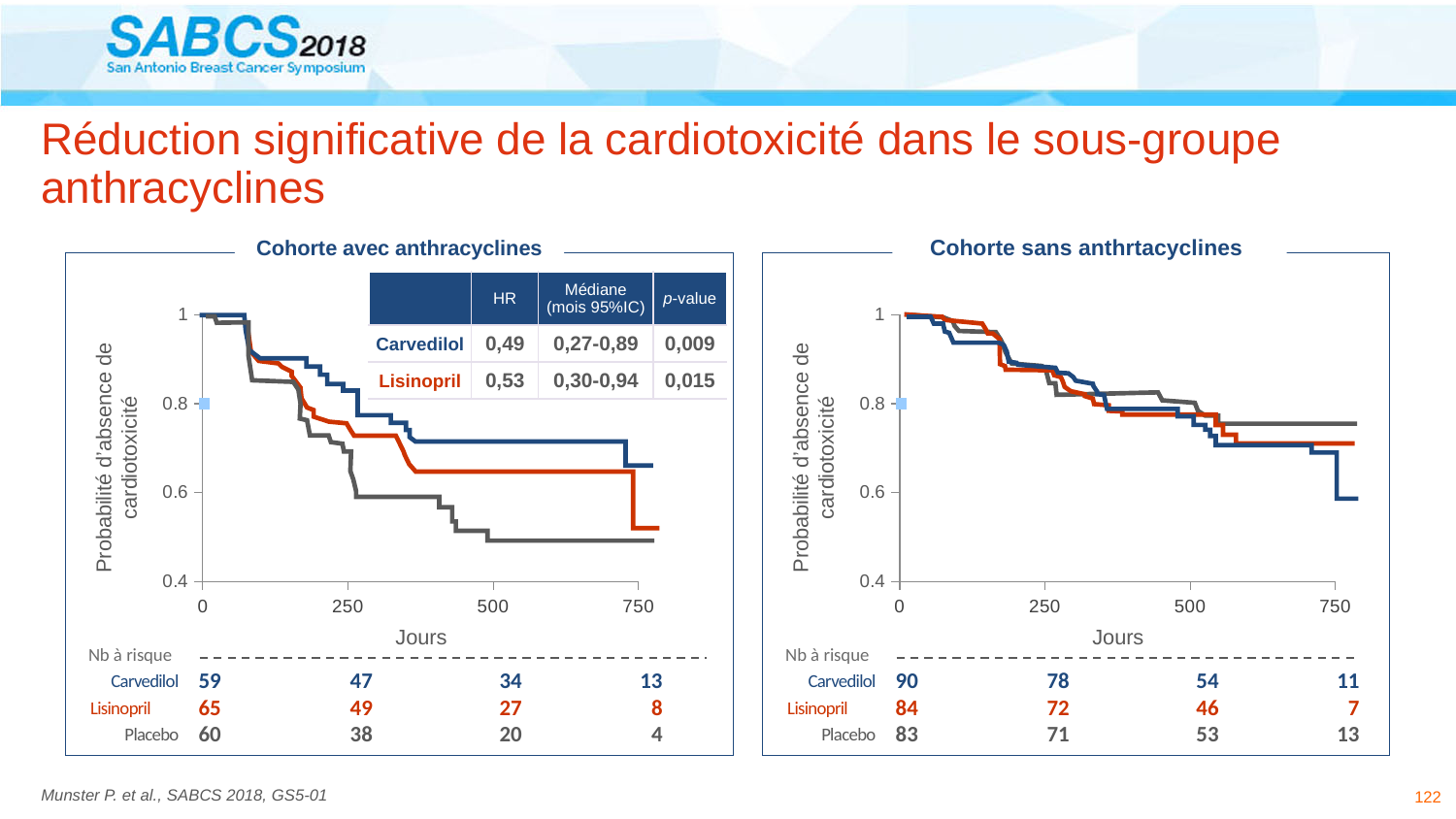
In the 'Cohorte avec anthracyclines' chart, what is the HR for Carvedilol in the inset table? 0,49 In the 'Cohorte sans anthrtacyclines' chart, which is larger at 750 days: the number at risk for Placebo or for Carvedilol? Placebo How many treatment groups are listed in the 'Nb à risque' table of the 'Cohorte sans anthrtacyclines' chart? 3 What kind of chart is shown under the title 'Cohorte avec anthracyclines'? Line chart In the 'Cohorte sans anthrtacyclines' chart, do the curves rise or fall as days increase? Fall In the 'Cohorte sans anthrtacyclines' chart, how many Lisinopril patients are at risk at 250 days? 72 In the 'Cohorte avec anthracyclines' chart, what is the p-value for Lisinopril in the inset table? 0,015 In the 'Cohorte avec anthracyclines' chart, is the Placebo curve at 500 days greater or less than 0.6? less In the 'Cohorte avec anthracyclines' chart, which group has the largest number at risk at day 0? Lisinopril In the 'Cohorte sans anthrtacyclines' chart, what is the difference between the Carvedilol and Lisinopril numbers at risk at 500 days? 8 In the 'Cohorte avec anthracyclines' chart, what is the difference between the Lisinopril and Carvedilol numbers at risk at day 0? 6 In the 'Cohorte avec anthracyclines' chart, how many Placebo patients are at risk at 750 days? 4